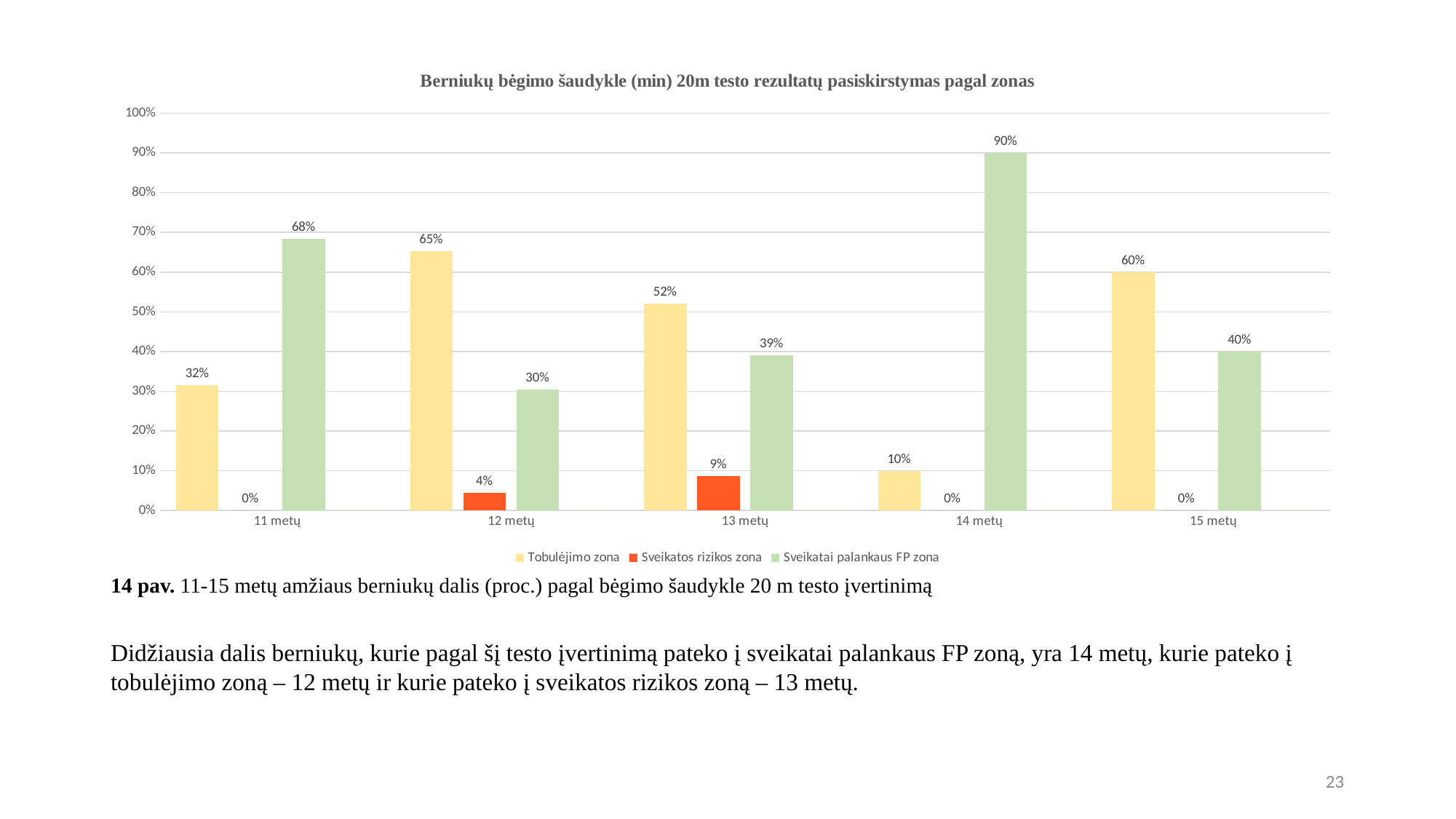
What is the value for Sveikatos rizikos zona at 13 metų? 9% What kind of chart is shown on the slide? Bar chart Which age group has the lowest value for Tobulėjimo zona? 14 metų What colour represents Sveikatos rizikos zona in the chart? Orange What is the value for Sveikatai palankaus FP zona at 14 metų? 90% What is the difference between Sveikatai palankaus FP zona and Tobulėjimo zona at 11 metų? 36% Which is larger at 15 metų: Tobulėjimo zona or Sveikatai palankaus FP zona? Tobulėjimo zona What is the value for Tobulėjimo zona at 12 metų? 65% Does the value for Sveikatai palankaus FP zona rise or fall from 11 metų to 12 metų? Fall How many age groups are shown on the x axis? 5 Which age group has the highest value for Sveikatai palankaus FP zona? 14 metų How many series does the legend list? 3